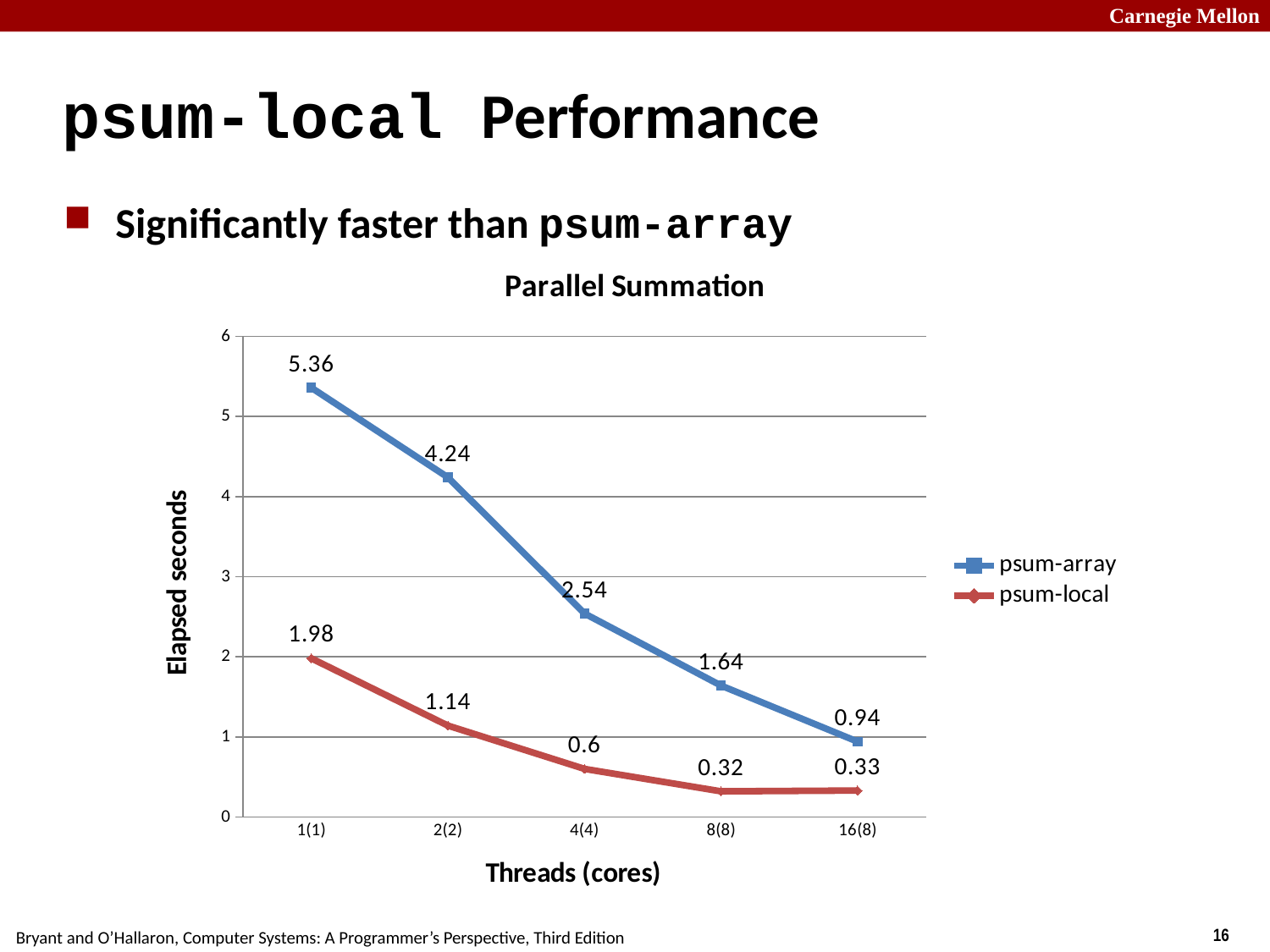
How many series does the legend list? 2 What is the elapsed seconds value for psum-local at 4(4) threads (cores)? 0.6 Does the psum-array series rise or fall as the number of threads increases along the x axis? fall At which threads (cores) setting is the psum-array series highest? 1(1) What is the elapsed seconds value for psum-array at 16(8) threads (cores)? 0.94 At which threads (cores) setting is the psum-local series lowest? 8(8) What is the elapsed seconds value for psum-array at 1(1) threads (cores)? 5.36 Which series has the larger value at 8(8) threads (cores), psum-array or psum-local? psum-array Is the value for psum-array at 4(4) threads (cores) greater or less than 2? greater What kind of chart is shown on the slide? line chart How many threads (cores) categories are shown on the x axis? 5 What is the difference between psum-array and psum-local at 2(2) threads (cores)? 3.1